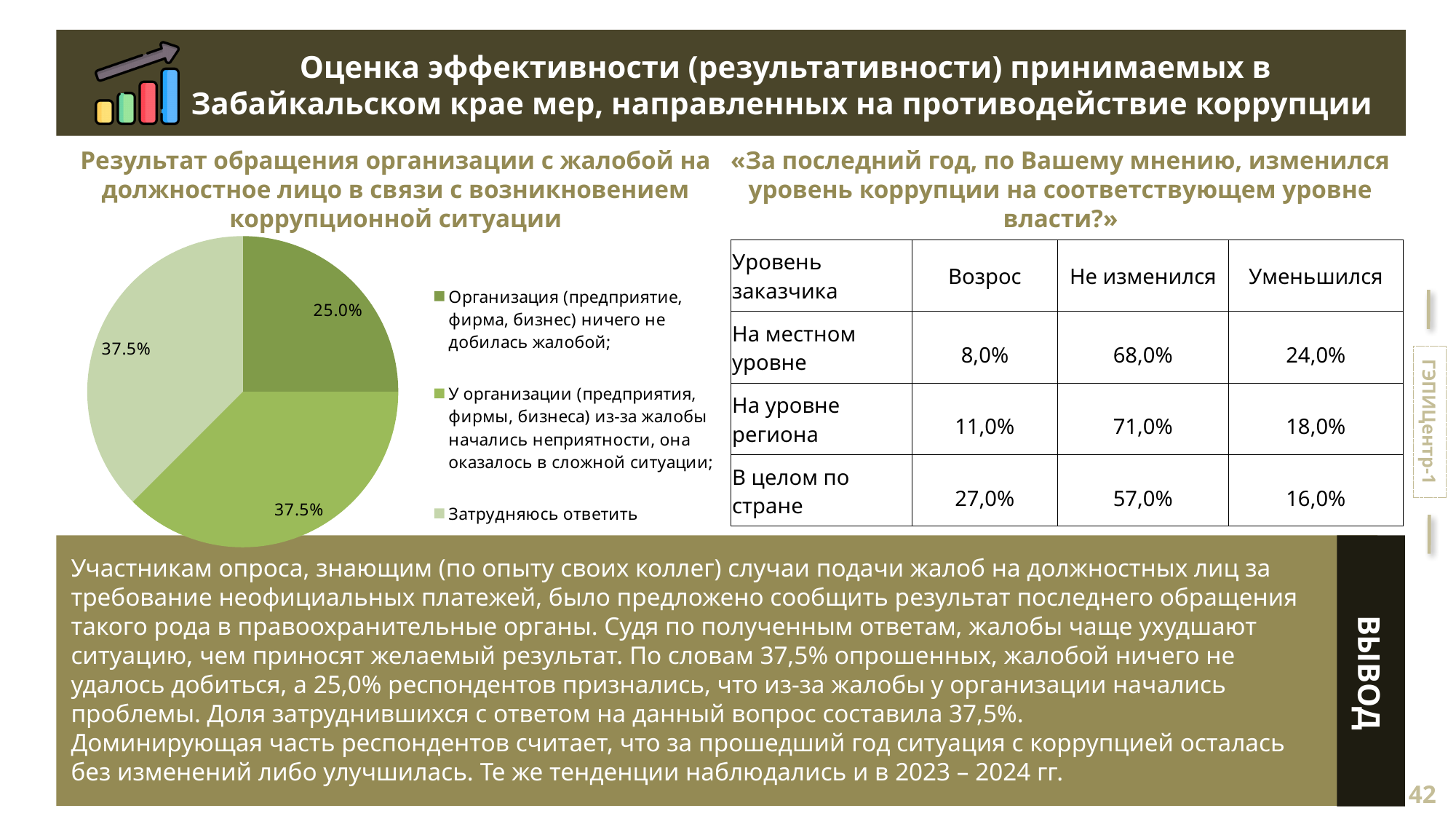
What kind of chart is shown on the left of the slide? pie chart Which slice of the pie chart is the smallest? Организация (предприятие, фирма, бизнес) ничего не добилась жалобой How many entries does the legend of the pie chart list? 3 In the pie chart, what share is shown for "Организация (предприятие, фирма, бизнес) ничего не добилась жалобой"? 25.0% Which legend entry of the pie chart is shown in the lightest green colour? Затрудняюсь ответить In the pie chart, what share is shown for "Затрудняюсь ответить"? 37.5% In the pie chart, which is larger: the share for "Затрудняюсь ответить" or the share for "Организация (предприятие, фирма, бизнес) ничего не добилась жалобой"? Затрудняюсь ответить What is the title of the pie chart? Результат обращения организации с жалобой на должностное лицо в связи с возникновением коррупционной ситуации How many slices does the pie chart have? 3 In the pie chart, what is the difference between the share for "Затрудняюсь ответить" and the share for "Организация (предприятие, фирма, бизнес) ничего не добилась жалобой"? 12.5% In the pie chart, what share is shown for "У организации (предприятия, фирмы, бизнеса) из-за жалобы начались неприятности, она оказалось в сложной ситуации"? 37.5% Is the share for "Организация (предприятие, фирма, бизнес) ничего не добилась жалобой" in the pie chart greater or less than 30%? less